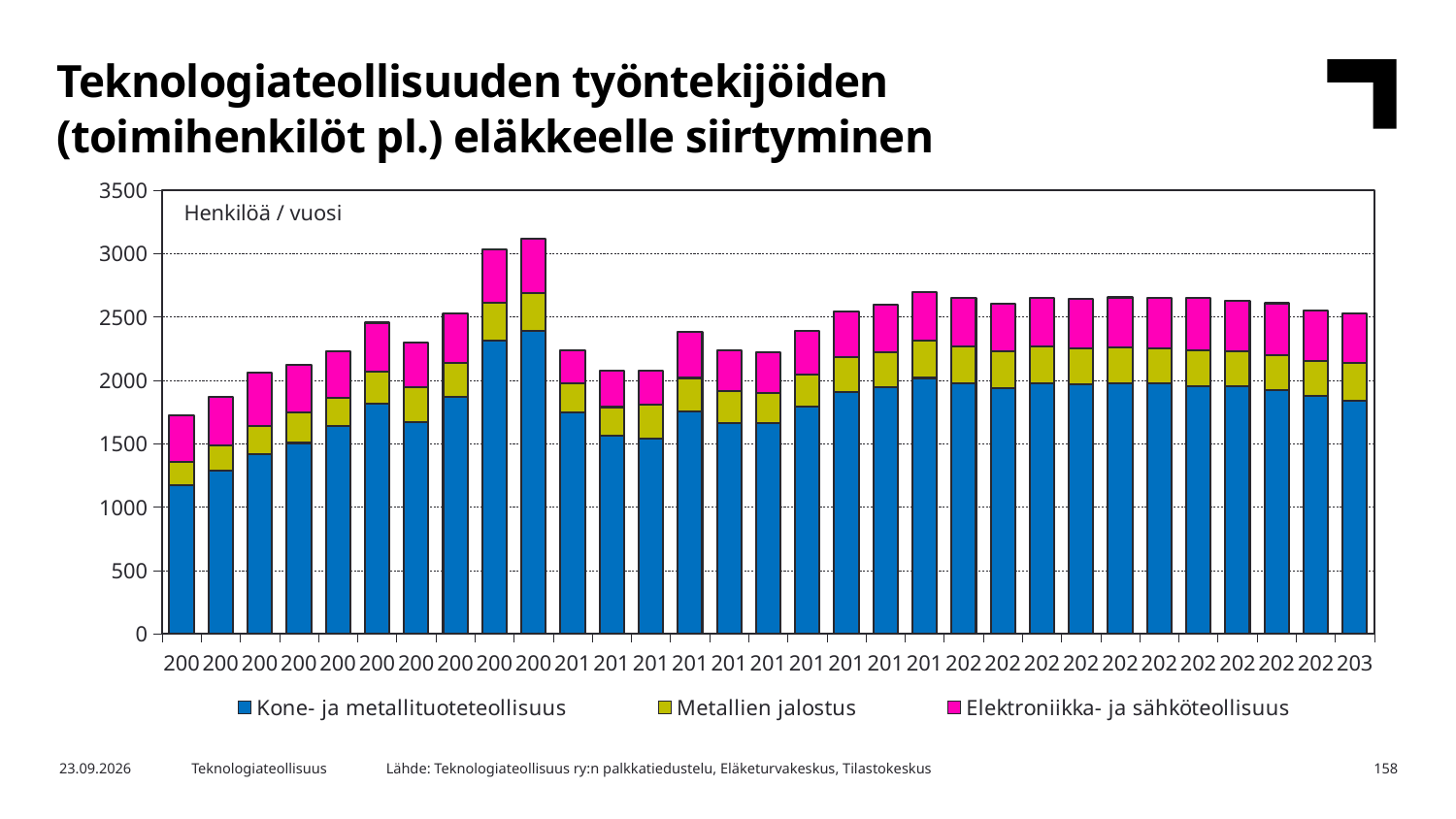
Comparing the leftmost bar with the rightmost bar, do the totals rise or fall? rise What unit label is shown inside the plot area of the chart? Henkilöä / vuosi What is the highest value shown on the y axis? 3500 How many series does the legend list? 3 How many bars are plotted in the chart? 31 Is the total of the rightmost bar greater or less than 2000? greater Which bar has the lowest total in the chart? The leftmost bar Which bar has the highest total: the leftmost bar or the tenth bar from the left? The tenth bar from the left Is the total of the tallest bar greater or less than 3000? greater Is the total of the leftmost bar greater or less than 2000? less What kind of chart is shown on the slide? Stacked bar chart Which series forms the bottom segment of each stacked bar? Kone- ja metallituoteteollisuus